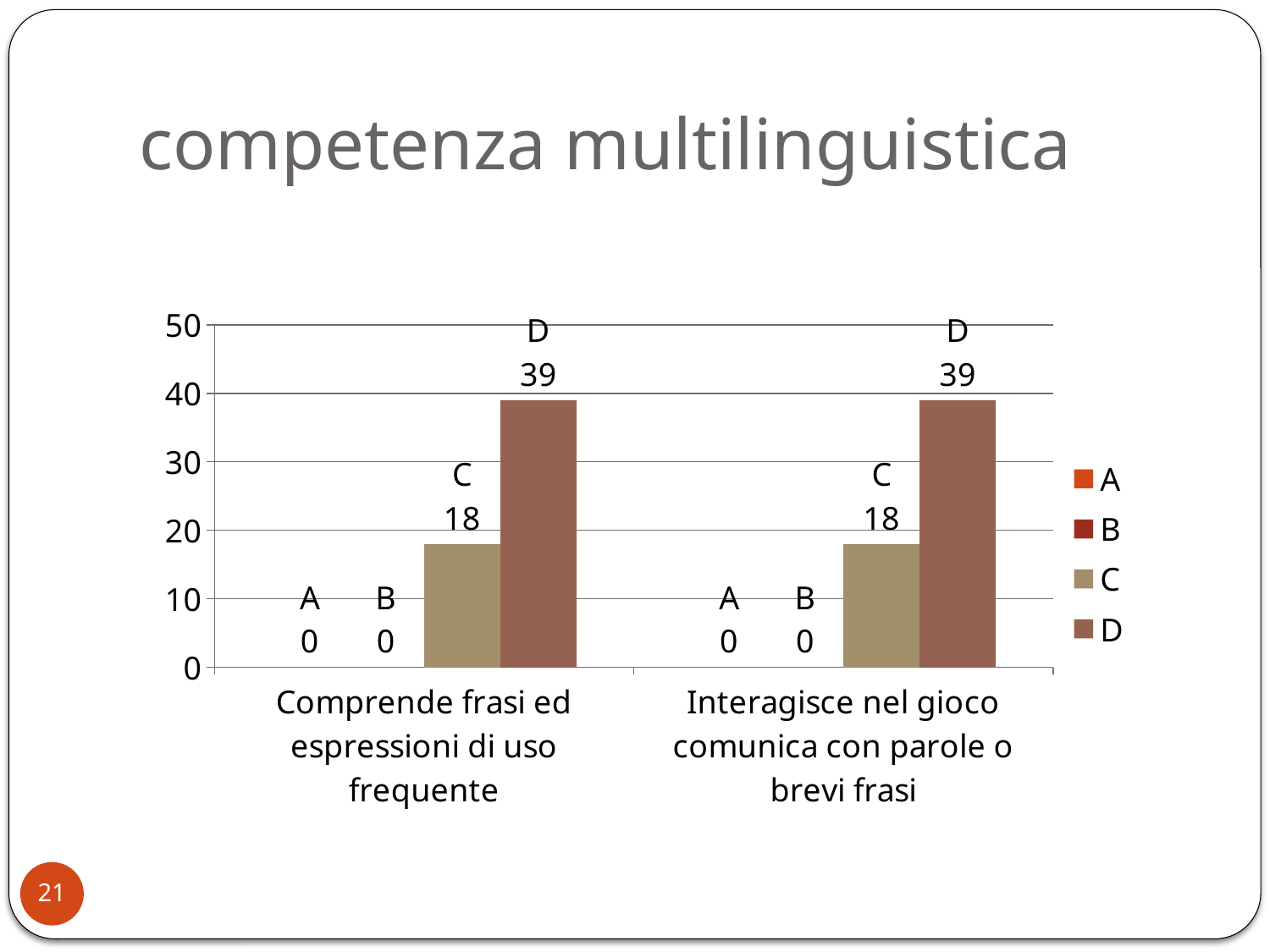
What is the value for series D in the category "Comprende frasi ed espressioni di uso frequente"? 39 What kind of chart is shown on the slide? bar chart Which is larger in the category "Comprende frasi ed espressioni di uso frequente": the value for C or the value for D? D Which series has the highest value in the category "Comprende frasi ed espressioni di uso frequente"? D What is the value for series C in the category "Interagisce nel gioco comunica con parole o brevi frasi"? 18 How many categories are shown on the x axis? 2 What is the value for series B in the category "Interagisce nel gioco comunica con parole o brevi frasi"? 0 What is the value for series A in the category "Comprende frasi ed espressioni di uso frequente"? 0 Is the value for D in the category "Interagisce nel gioco comunica con parole o brevi frasi" greater or less than 30? greater How many series does the legend list? 4 What is the difference between the values for D and C in the category "Interagisce nel gioco comunica con parole o brevi frasi"? 21 What is the title of the slide containing the chart? competenza multilinguistica